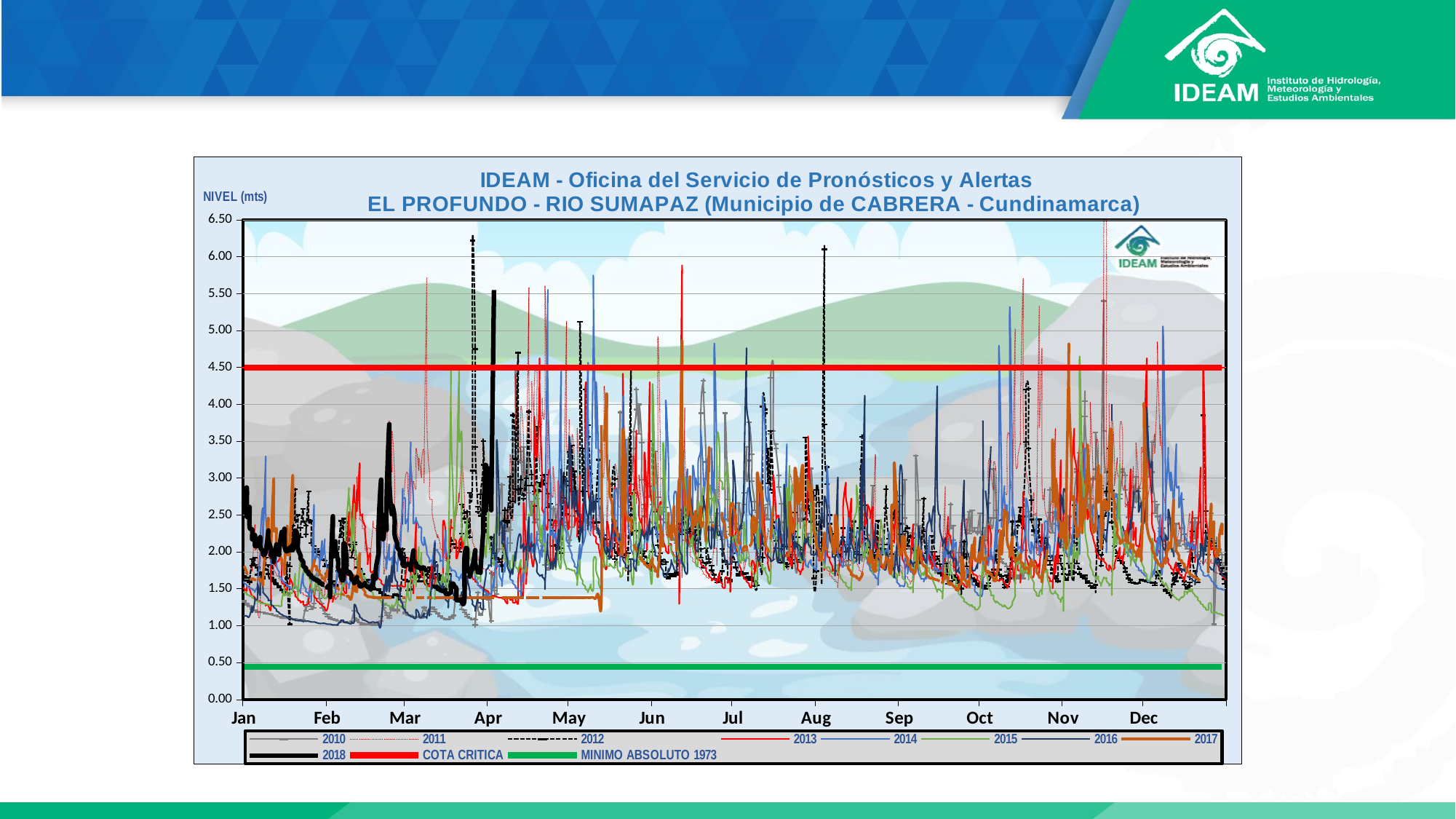
Which horizontal reference line is higher, COTA CRITICA or MINIMO ABSOLUTO 1973? COTA CRITICA What is the second line of the chart title? EL PROFUNDO - RIO SUMAPAZ (Municipio de CABRERA - Cundinamarca) Is the peak of the 2018 series in April greater or less than 5.00? greater How many months are labelled along the x axis of the chart? 12 Is the peak of the 2018 series in February greater or less than 3.00? greater Is the MINIMO ABSOLUTO 1973 line greater or less than 1.00? less What kind of chart is shown on the slide? line chart How many series does the chart legend list? 11 What is the highest tick value shown on the y axis of the chart? 6.50 At what level (in mts) is the COTA CRITICA horizontal line drawn? 4.50 Which year's series is drawn as a thick solid black line? 2018